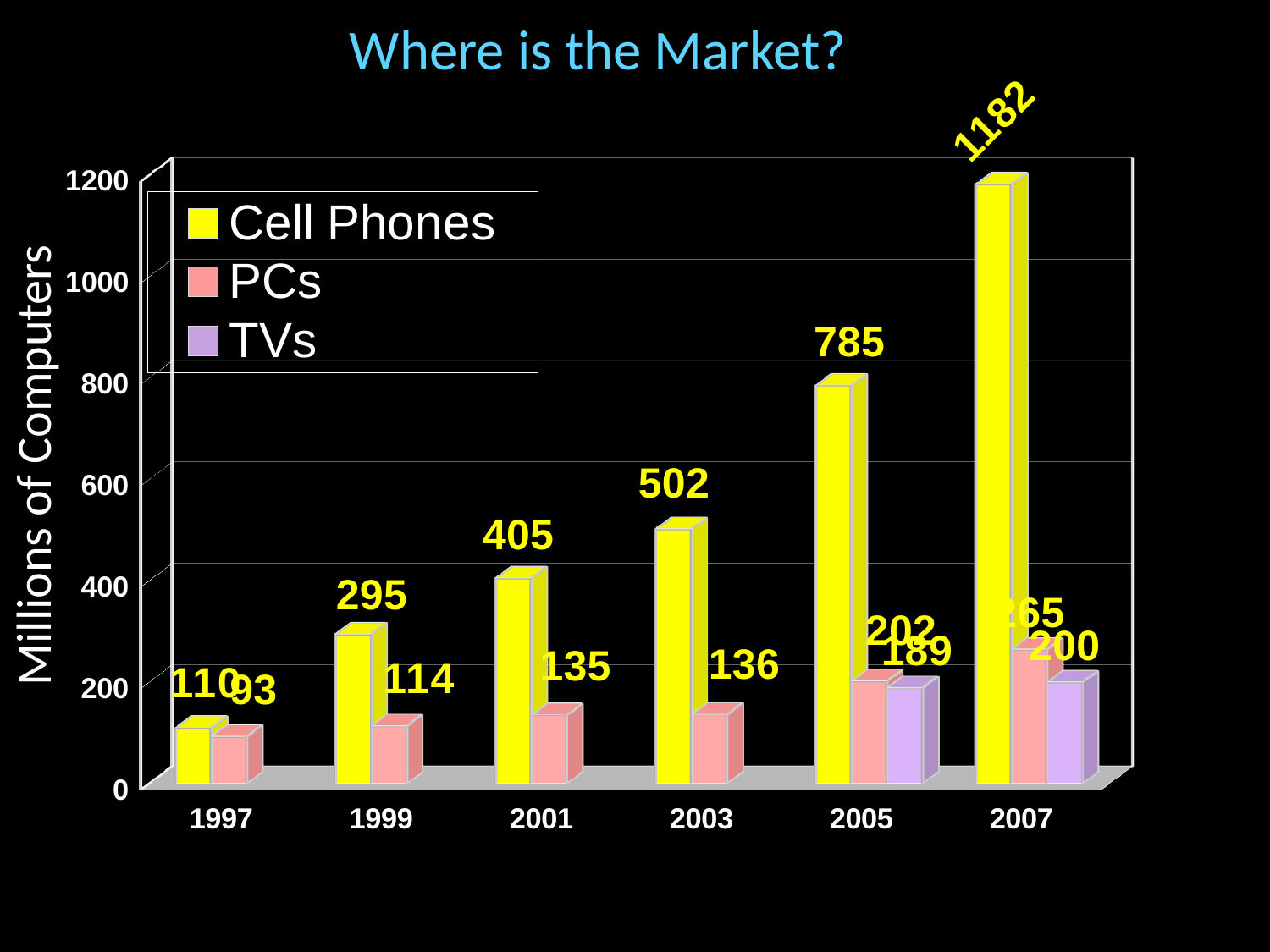
Is the value for Cell Phones in 1999 greater or less than 400? less What is the difference between the Cell Phones values for 2005 and 2003? 283 What kind of chart is shown on the slide? bar chart Do the Cell Phones values rise or fall from 1997 to 2007? rise In which year is the Cell Phones value highest? 2007 In which year is the PCs value lowest? 1997 What is the value for Cell Phones in 2007? 1182 How many series does the legend list? 3 How many years are shown on the x axis? 6 What is the value for TVs in 2005? 189 What is the value for PCs in 2001? 135 In 2005, which is larger: PCs or TVs? PCs